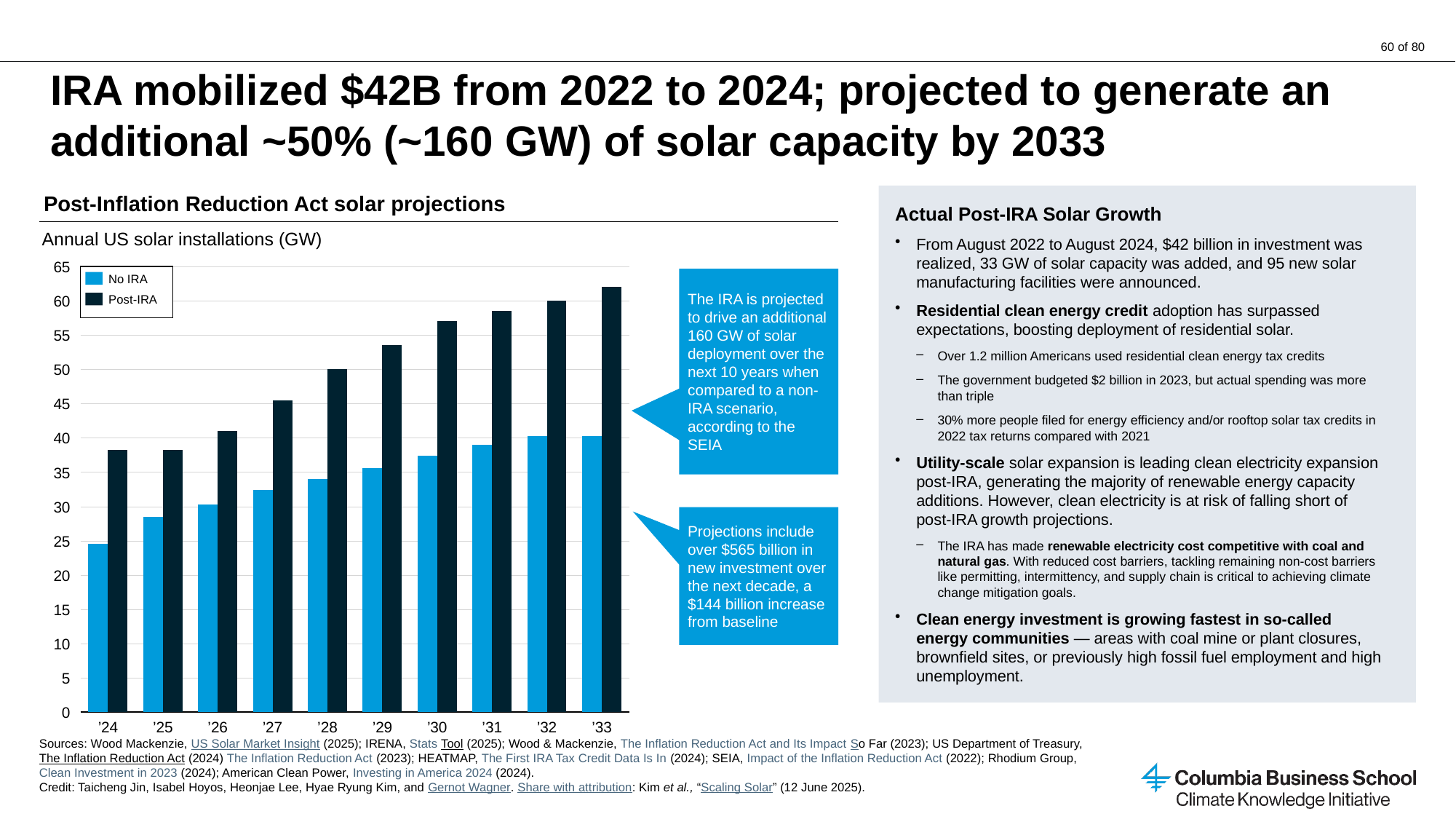
Which year has the highest Post-IRA value in the chart? '33 In '33, which is larger: the No IRA value or the Post-IRA value? Post-IRA Which year has the lowest No IRA value in the chart? '24 Is the Post-IRA value for '30 greater or less than 55? greater Is the No IRA value for '24 greater or less than 30? less What unit is used for the annual US solar installations shown on the chart's y axis? GW Is the No IRA value for '29 greater or less than 40? less What kind of chart is shown on the slide? Bar chart How many years are shown along the x axis of the chart? 10 Do the Post-IRA values rise or fall from '24 to '33? Rise How many series does the chart legend list? 2